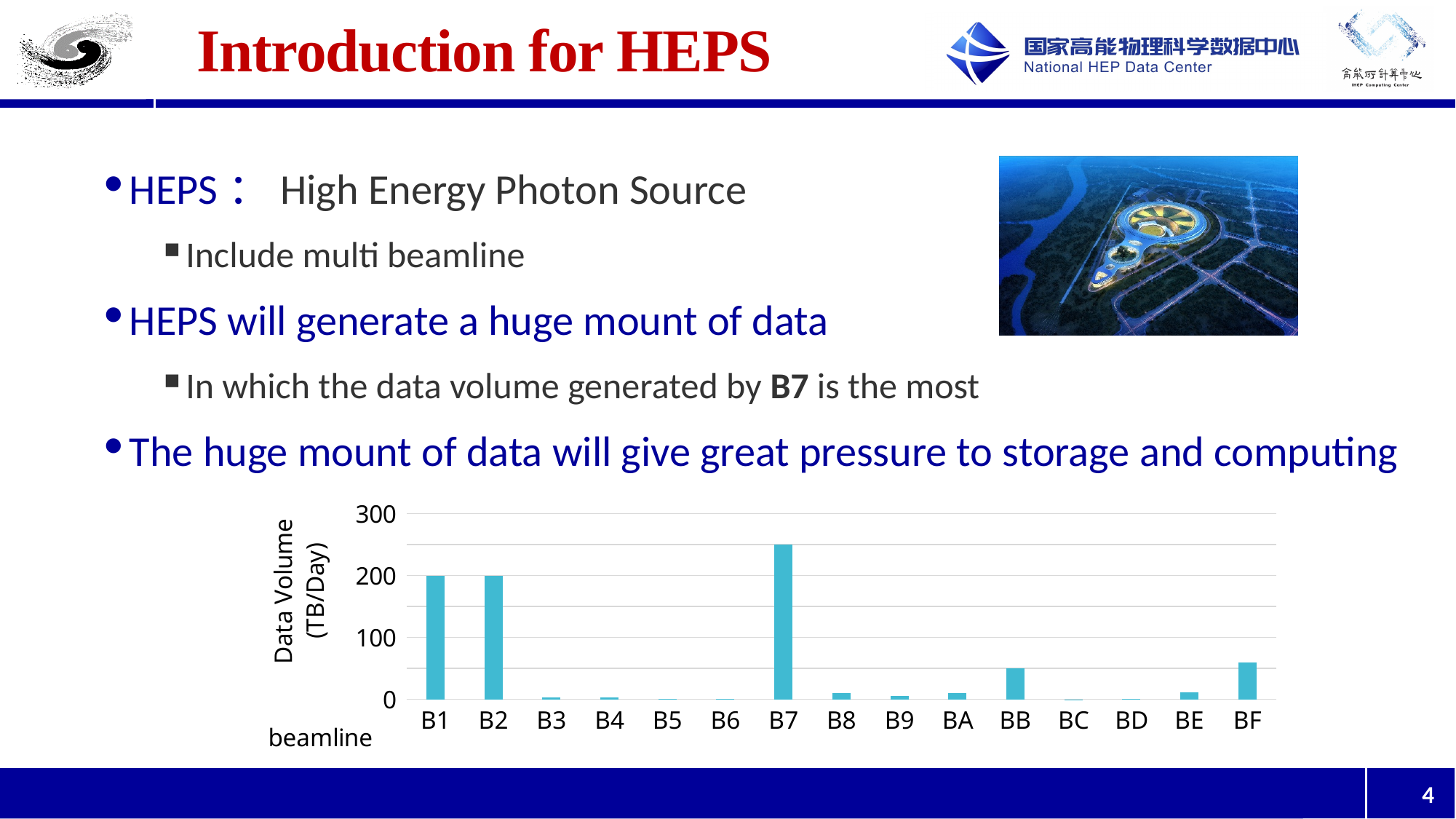
What kind of chart is shown on the slide? bar chart What is the data volume for B1 in TB/Day? 200 Is the data volume for B7 greater or less than 200? greater Which has a larger data volume, B1 or B7? B7 Which has a larger data volume, BB or B8? BB Which beamline has the highest data volume in the chart? B7 Is the data volume for B1 greater or less than 100? greater What is the label of the y axis of the chart? Data Volume (TB/Day) How many beamlines are shown on the x axis of the chart? 15 What is the label of the x axis of the chart? beamline Is the data volume for BF greater or less than 100? less